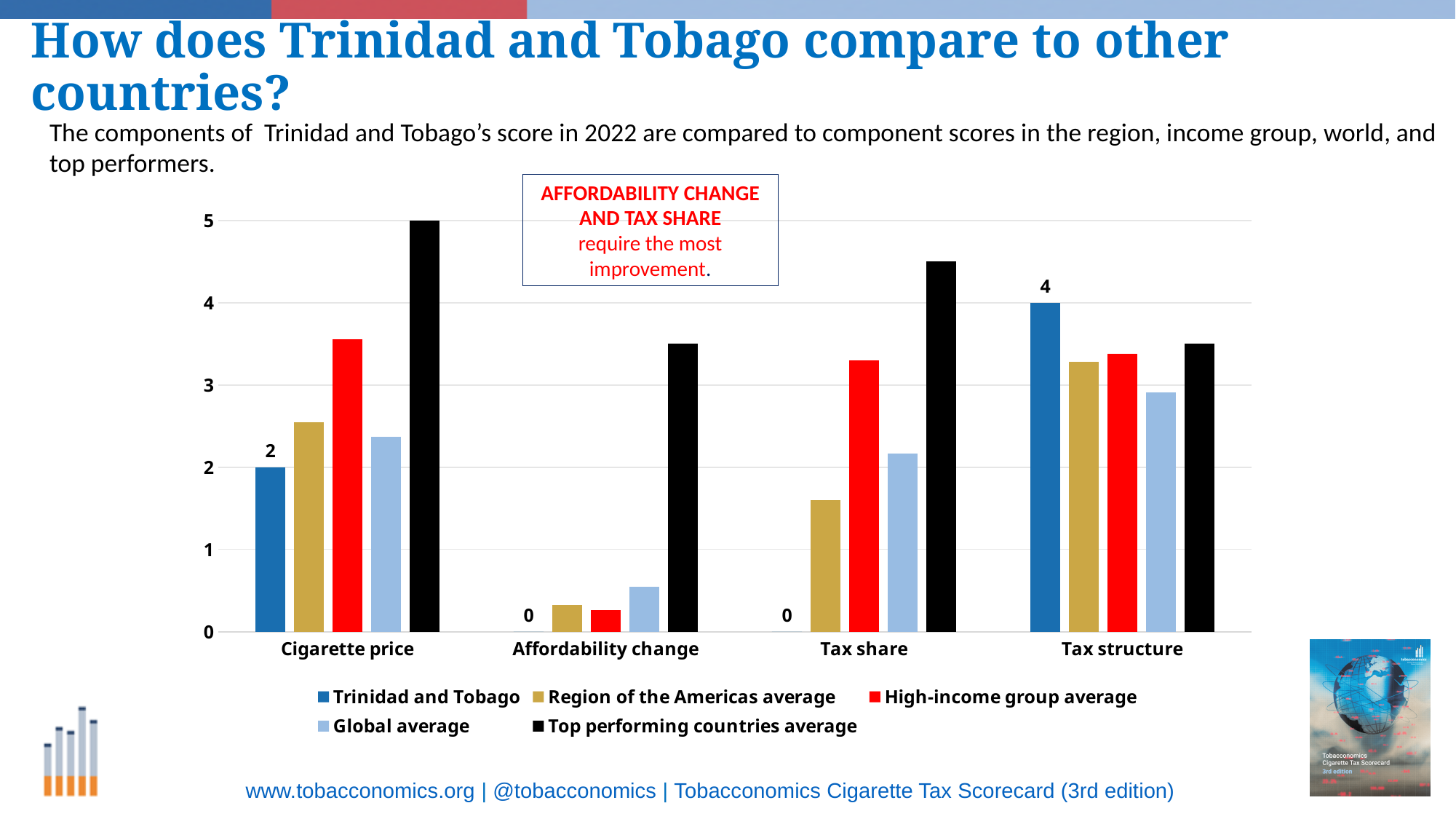
How many categories are shown on the x axis? 4 What is the value for Trinidad and Tobago in the Cigarette price category? 2 Is the value for Global average in the Affordability change category greater or less than 1? less What kind of chart is shown on the slide? bar chart What is the value for Trinidad and Tobago in the Affordability change category? 0 What is the difference between Trinidad and Tobago's Tax structure value and its Cigarette price value? 2 In which category does Trinidad and Tobago have its highest value? Tax structure How many series does the legend list? 5 In the Cigarette price category, which is larger: Trinidad and Tobago or Top performing countries average? Top performing countries average What is the value for Top performing countries average in the Cigarette price category? 5 What is the value for Trinidad and Tobago in the Tax structure category? 4 Is the value for Top performing countries average in the Tax share category greater or less than 4? greater